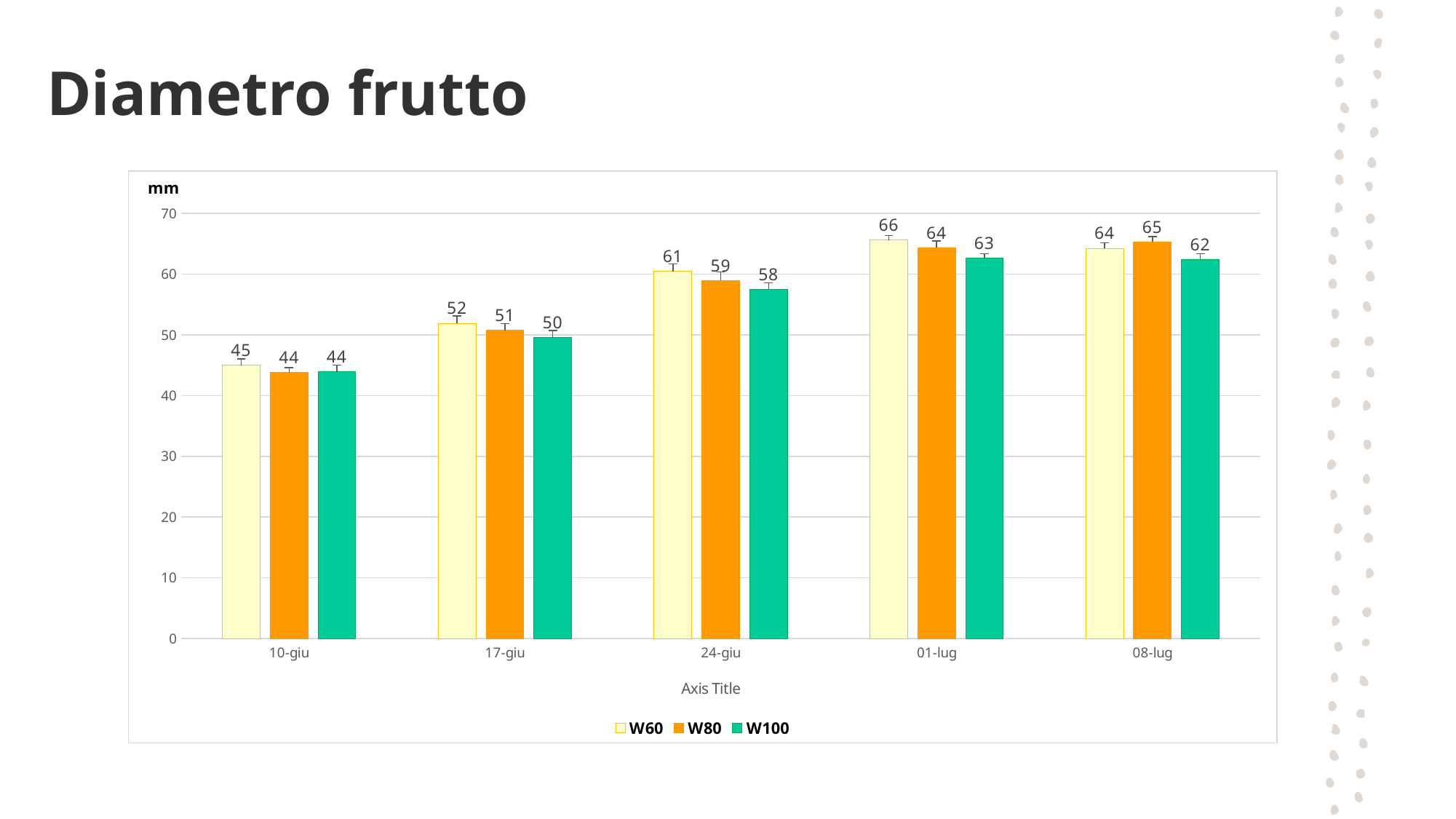
Is the value for W80 on 17-giu greater or less than 60? less How many series does the legend list? 3 What is the value for W100 on 17-giu? 50 Which is larger on 08-lug, W60 or W80? W80 How many dates are shown on the x axis? 5 On which date is the W100 value lowest? 10-giu Does the W80 value rise or fall from 10-giu to 01-lug? rise What is the value for W80 on 08-lug? 65 What is the value for W60 on 24-giu? 61 What is the difference between the W60 and W100 values on 24-giu? 3 What kind of chart is shown? bar chart On which date is the W60 value highest? 01-lug